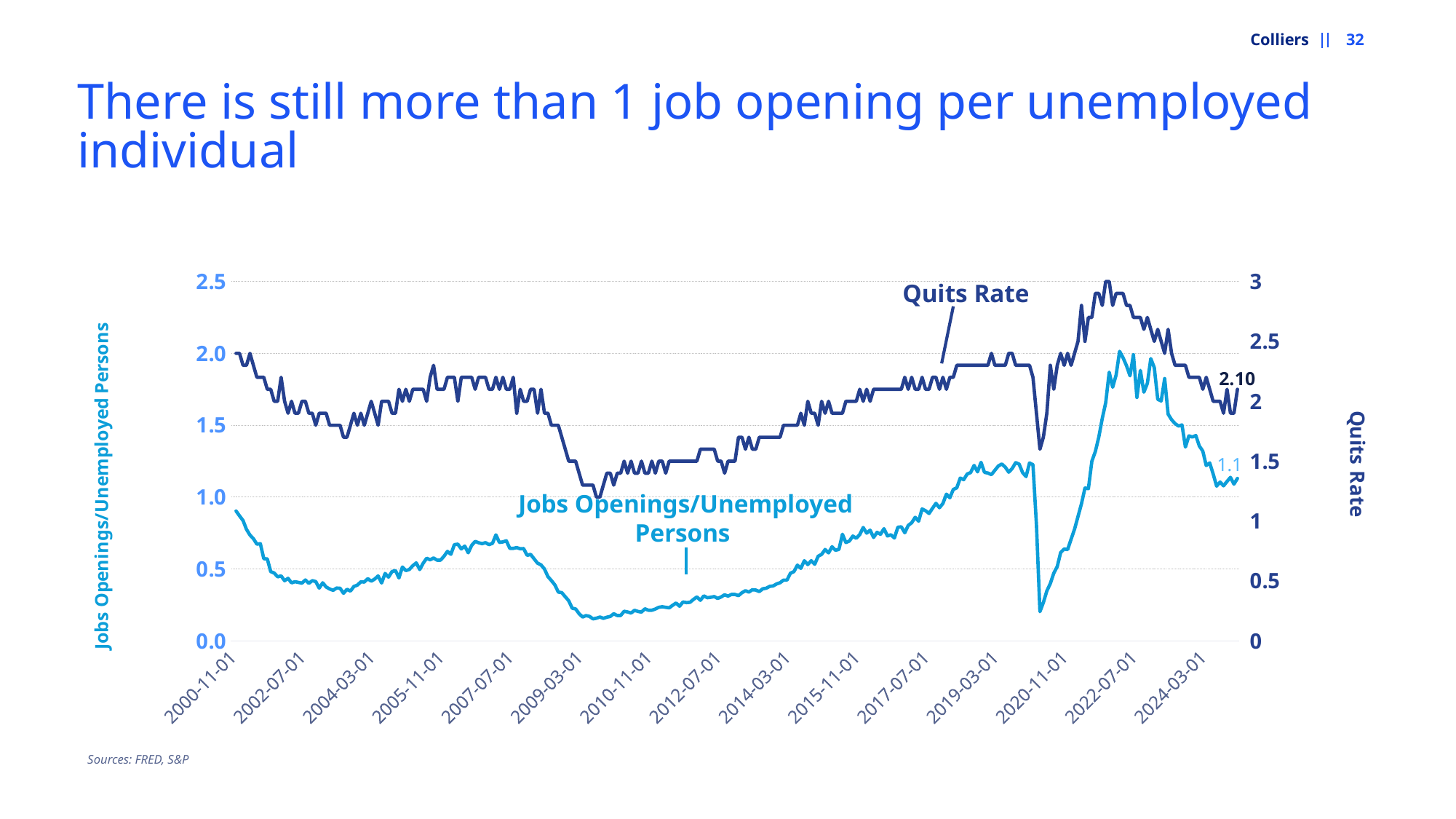
Which series has the higher final labelled value, Quits Rate or Jobs Openings/Unemployed Persons? Quits Rate Is the value of Jobs Openings/Unemployed Persons at 2022-07-01 greater or less than 1.5? greater What kind of chart is shown on the slide? line chart What is the latest labelled value of the Quits Rate series? 2.10 What is the title of the right-hand vertical axis? Quits Rate How many date labels are shown on the x axis? 15 What sources are cited for the chart? FRED, S&P Does the Jobs Openings/Unemployed Persons series rise or fall between 2022-07-01 and 2024-03-01? fall How many data series are plotted on the chart? 2 Is the Quits Rate at 2022-07-01 greater or less than 2.5? greater What is the latest labelled value of the Jobs Openings/Unemployed Persons series? 1.1 Is the value of Jobs Openings/Unemployed Persons at 2009-03-01 greater or less than 0.5? less